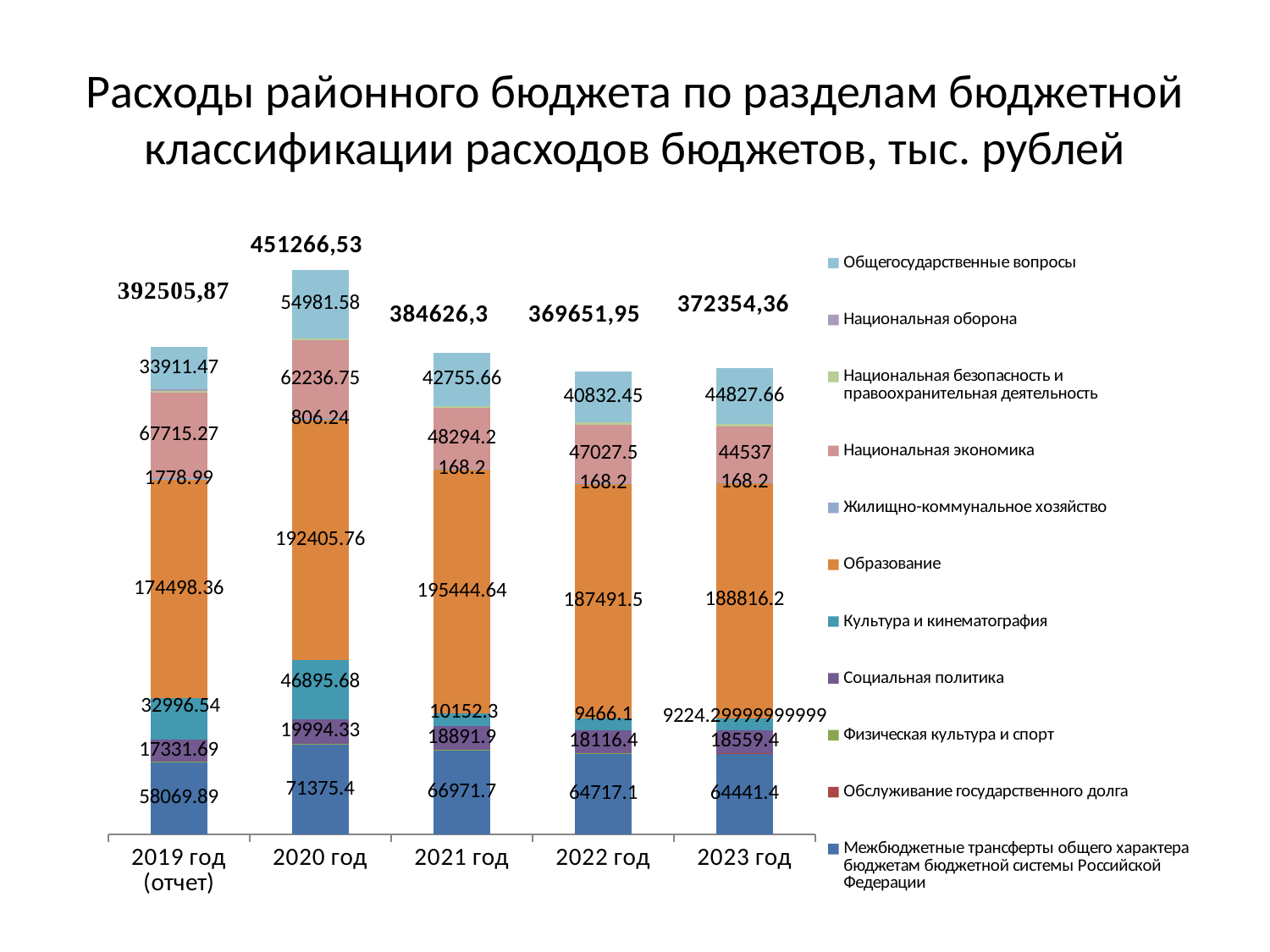
What is the difference between the total for 2020 год and the total for 2019 год (отчет)? 58760,66 How many series does the legend list? 11 Do the values for Национальная экономика rise or fall from 2019 to 2023? Fall What is the total of the stacked bar for 2020 год? 451266,53 Which is larger: the value for Общегосударственные вопросы in 2019 год (отчет) or in 2020 год? 2020 год What is the value for Образование in 2021 год? 195444.64 How many years (categories) are shown on the x axis? 5 What is the value for Межбюджетные трансферты общего характера бюджетам бюджетной системы Российской Федерации in 2023 год? 64441.4 What kind of chart is shown on the slide? Stacked bar chart What is the value for Национальная экономика in 2019 год (отчет)? 67715.27 Which year has the lowest total expenditure? 2022 год Which year has the highest total expenditure? 2020 год